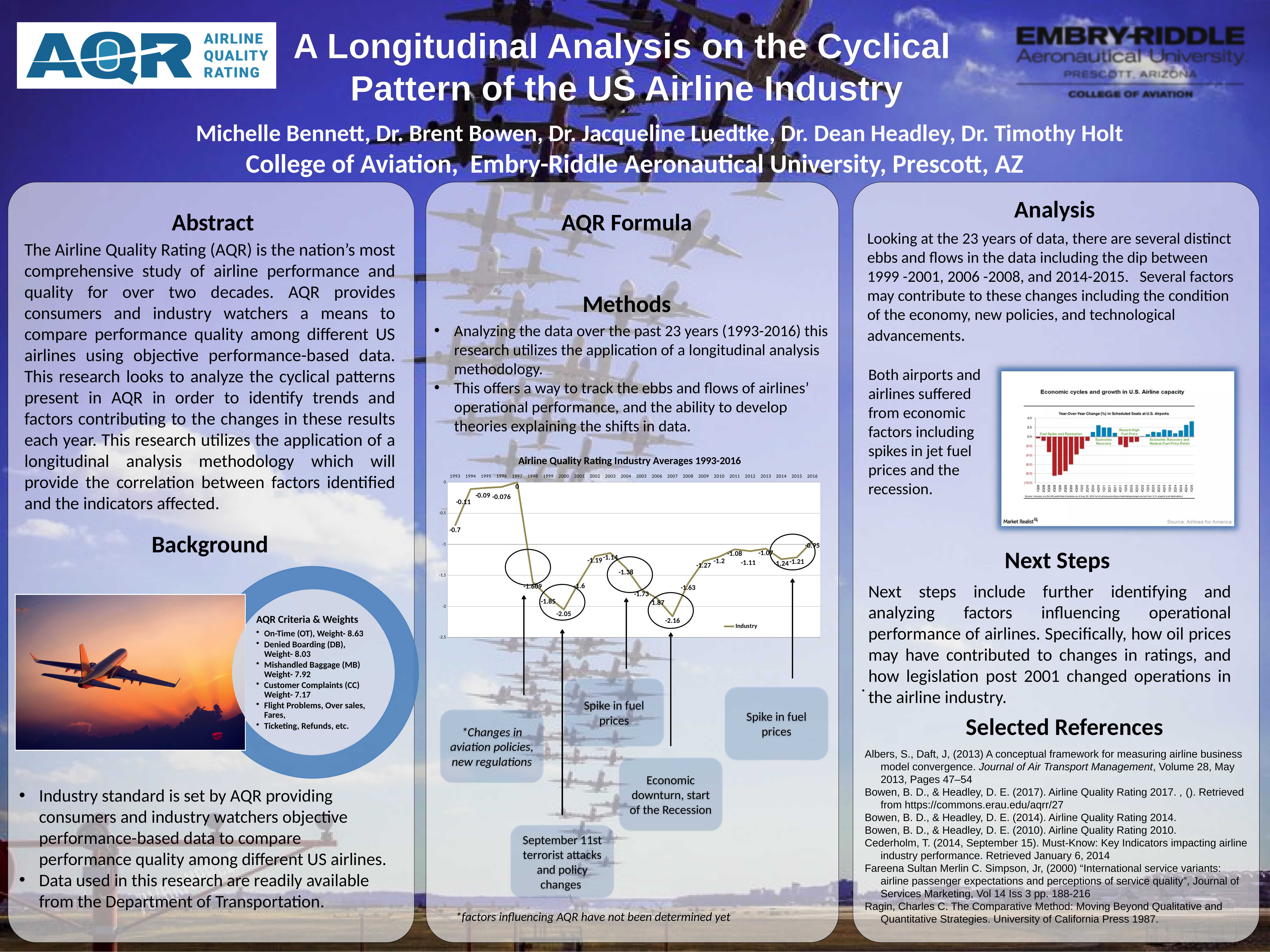
In the chart titled 'Airline Quality Rating Industry Averages 1993-2016', what is the difference between the values for 2001 and 2000? 0.45 In the chart titled 'Airline Quality Rating Industry Averages 1993-2016', which year has the highest value? 1997 In the chart titled 'Airline Quality Rating Industry Averages 1993-2016', what is the value for 2016? -0.95 What kind of chart is 'Airline Quality Rating Industry Averages 1993-2016'? line chart In the chart titled 'Airline Quality Rating Industry Averages 1993-2016', do the values rise or fall from 1993 to 1997? rise In the chart titled 'Airline Quality Rating Industry Averages 1993-2016', what is the value for 2000? -2.05 In the chart titled 'Airline Quality Rating Industry Averages 1993-2016', what is the value for 1997? 0 In the chart titled 'Airline Quality Rating Industry Averages 1993-2016', how many years are plotted? 24 In the chart titled 'Airline Quality Rating Industry Averages 1993-2016', what is the name of the series shown in the legend? Industry In the chart titled 'Airline Quality Rating Industry Averages 1993-2016', which year has the lowest value? 2007 In the chart titled 'Airline Quality Rating Industry Averages 1993-2016', which year has the larger value, 1999 or 2005? 2005 In the chart titled 'Airline Quality Rating Industry Averages 1993-2016', how many series does the legend list? 1